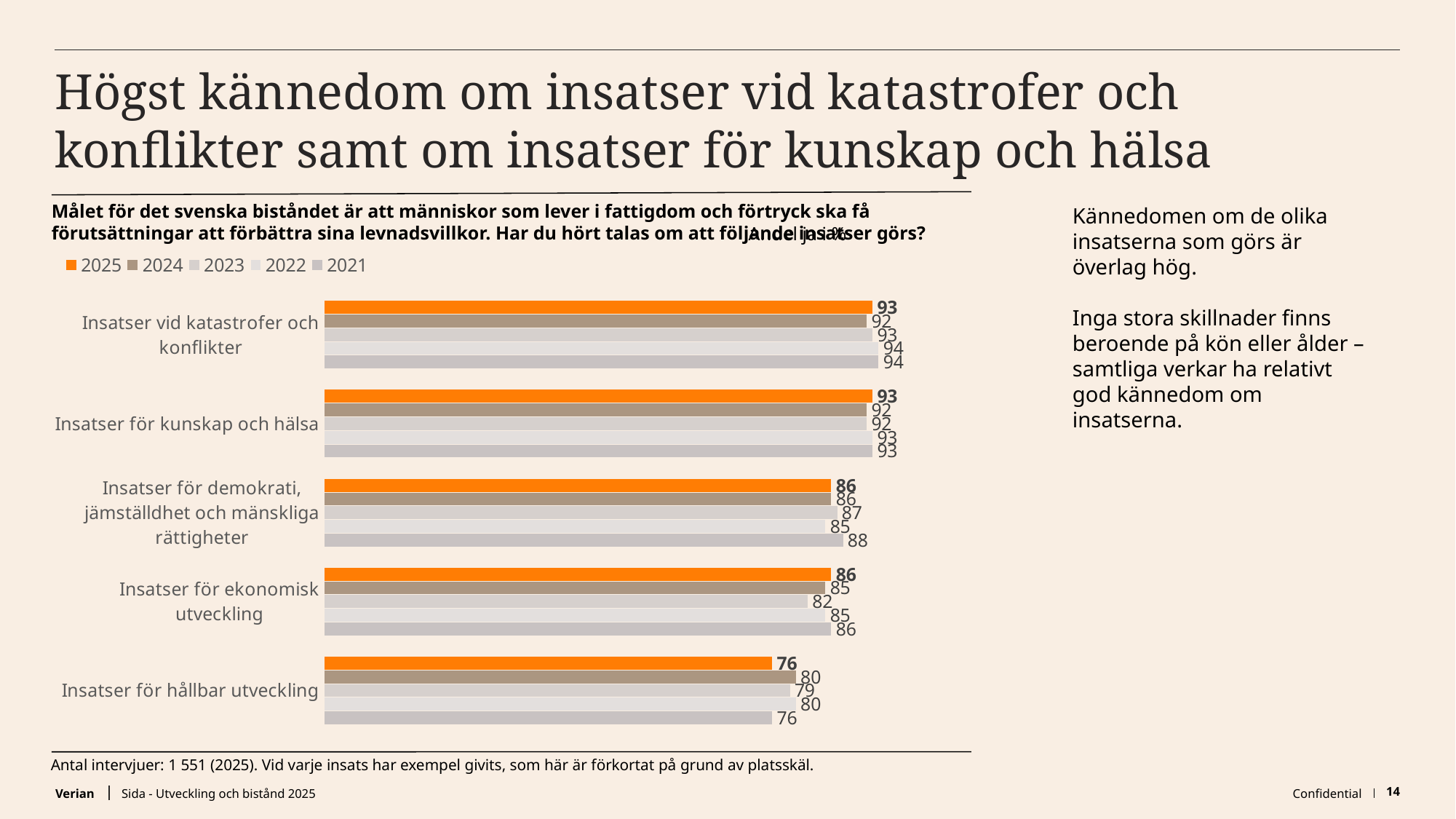
What is the 2022 value for "Insatser vid katastrofer och konflikter"? 94 What kind of chart is shown on the slide? Bar chart What is the 2025 value for "Insatser för hållbar utveckling"? 76 What is the difference between the 2024 and 2025 values for "Insatser för hållbar utveckling"? 4 Which is larger for "Insatser för ekonomisk utveckling": the 2025 value or the 2023 value? 2025 Which series is shown in orange in the chart? 2025 Which category has the lowest 2025 value? Insatser för hållbar utveckling What is the 2023 value for "Insatser för ekonomisk utveckling"? 82 How many series does the legend list? 5 How many categories are shown in the chart? 5 What is the 2021 value for "Insatser för demokrati, jämställdhet och mänskliga rättigheter"? 88 What is the difference between the 2025 values for "Insatser för kunskap och hälsa" and "Insatser för hållbar utveckling"? 17